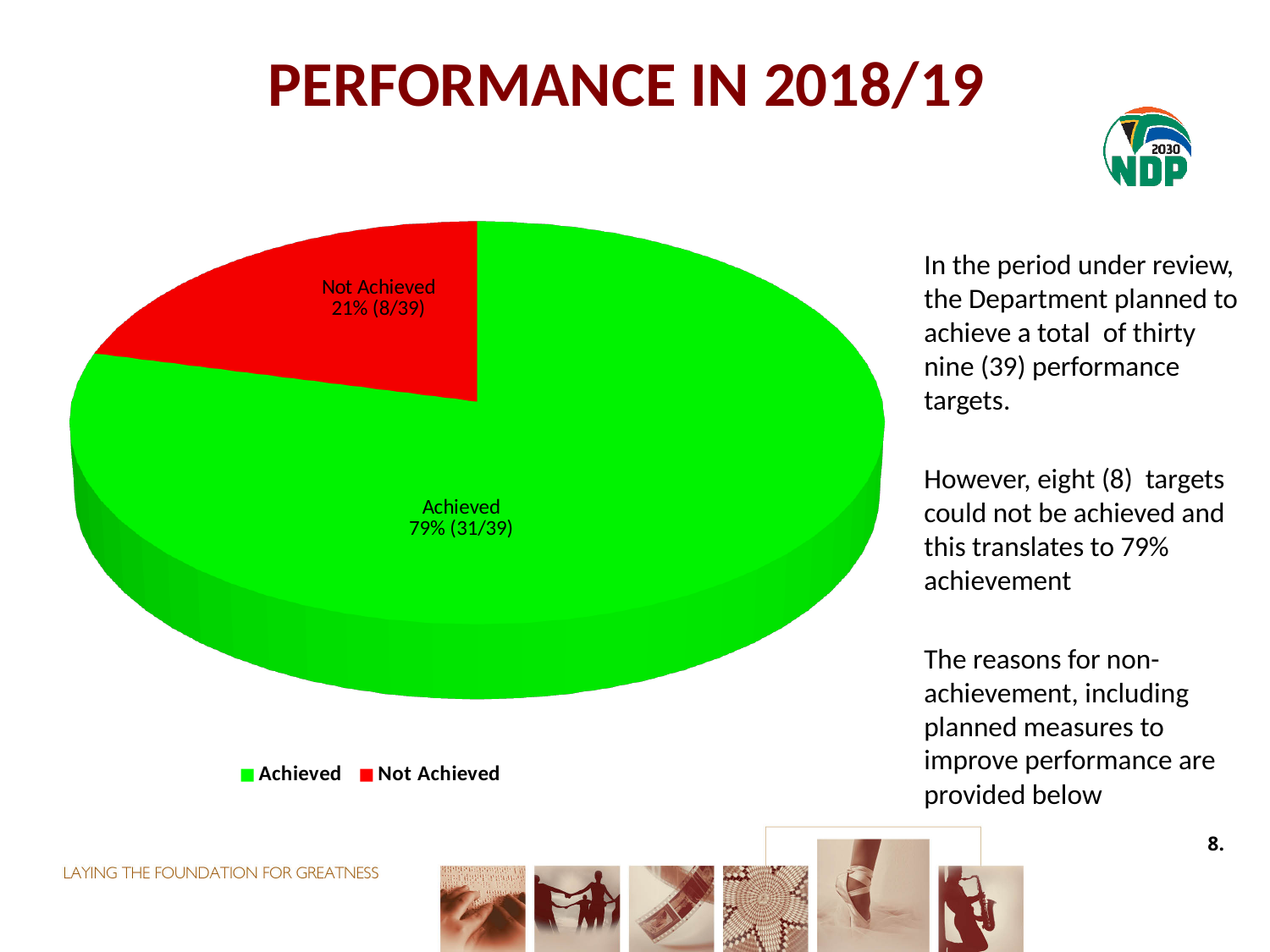
What colour is the Not Achieved slice? red How many targets were not achieved according to the Not Achieved slice label? 8 How many slices does the pie chart have? 2 What share of the pie does the Achieved slice represent? 79% How many entries does the legend list? 2 What kind of chart is shown on the slide? pie chart How many targets were achieved according to the Achieved slice label? 31 What is the difference in percentage points between the Achieved and Not Achieved slices? 58 What share of the pie does the Not Achieved slice represent? 21% Which slice is the smallest in the pie chart? Not Achieved Which is larger, the Achieved slice or the Not Achieved slice? Achieved Which slice is the largest in the pie chart? Achieved